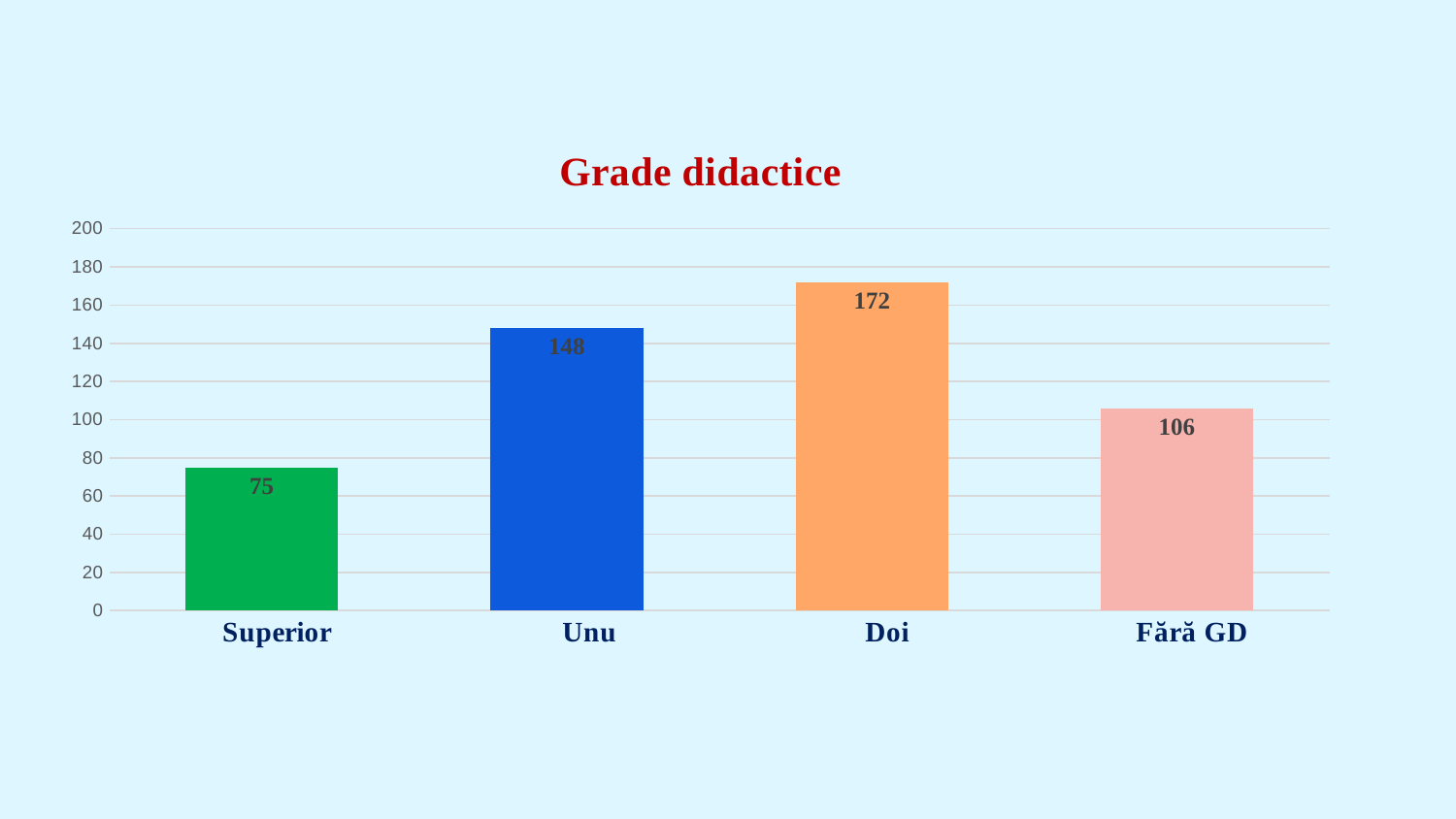
What is the title of the chart? Grade didactice What kind of chart is this? Bar chart Which category has the highest value? Doi What is the difference between the values for Doi and Unu? 24 What is the value for Doi? 172 Which category has the lowest value? Superior What is the value for Superior? 75 What is the value for Unu? 148 How many categories are shown on the x axis? 4 What is the difference between the values for Fără GD and Superior? 31 What is the value for Fără GD? 106 Which is larger, the value for Unu or the value for Fără GD? Unu